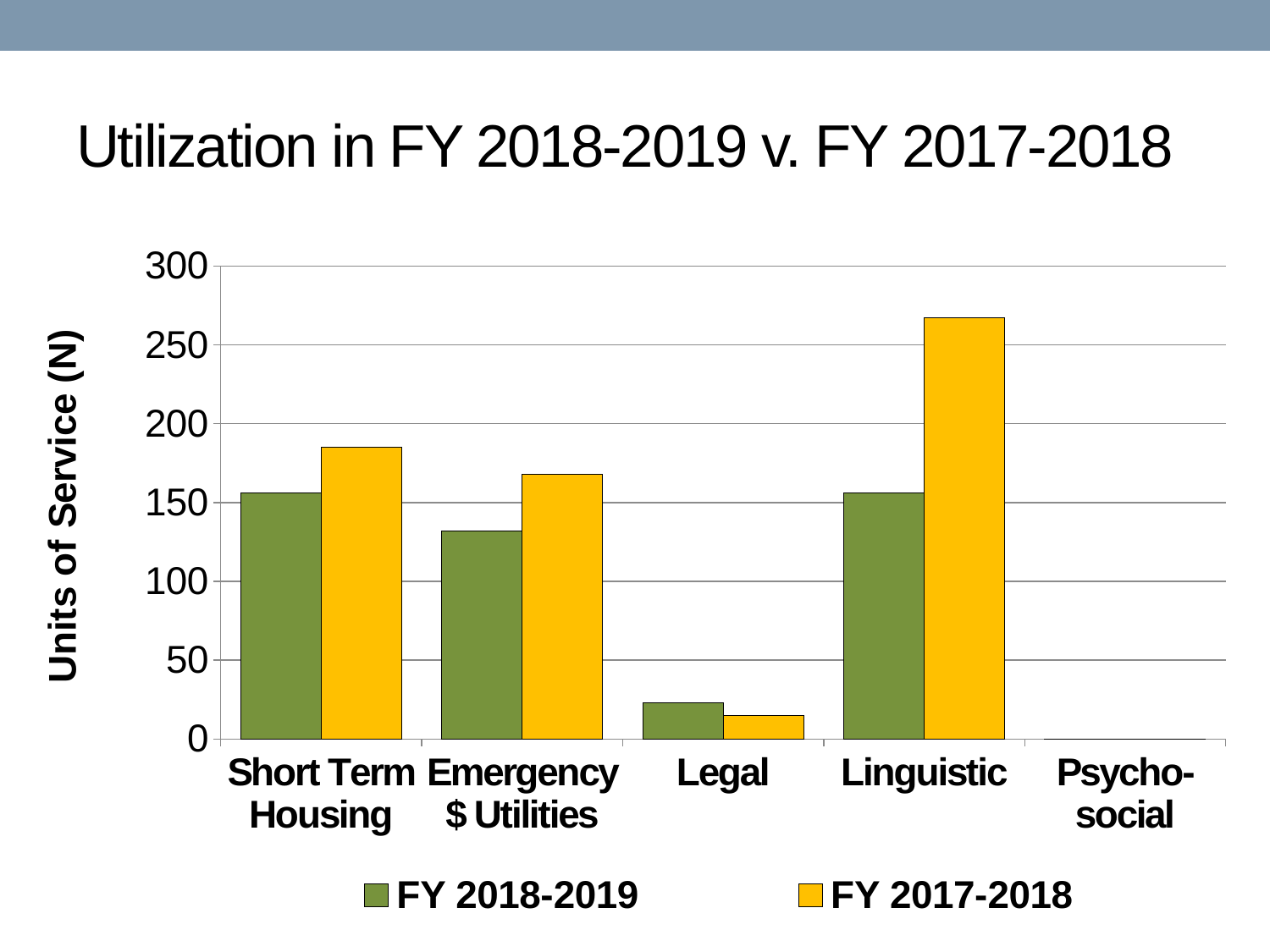
What is the title of the y axis? Units of Service (N) How many service categories are shown on the x axis? 5 Is the FY 2018-2019 value for Emergency $ Utilities greater or less than 150? less Which category has the lowest FY 2017-2018 value? Psycho-social For Short Term Housing, which series has the larger value, FY 2018-2019 or FY 2017-2018? FY 2017-2018 How many series does the legend list? 2 Which category has the highest FY 2017-2018 value? Linguistic Is the FY 2017-2018 value for Linguistic greater or less than 250? greater Is the FY 2017-2018 value for Short Term Housing greater or less than 150? greater What kind of chart is shown on the slide? Bar chart What colour represents the FY 2017-2018 series? Yellow For Legal, which series has the larger value, FY 2018-2019 or FY 2017-2018? FY 2018-2019